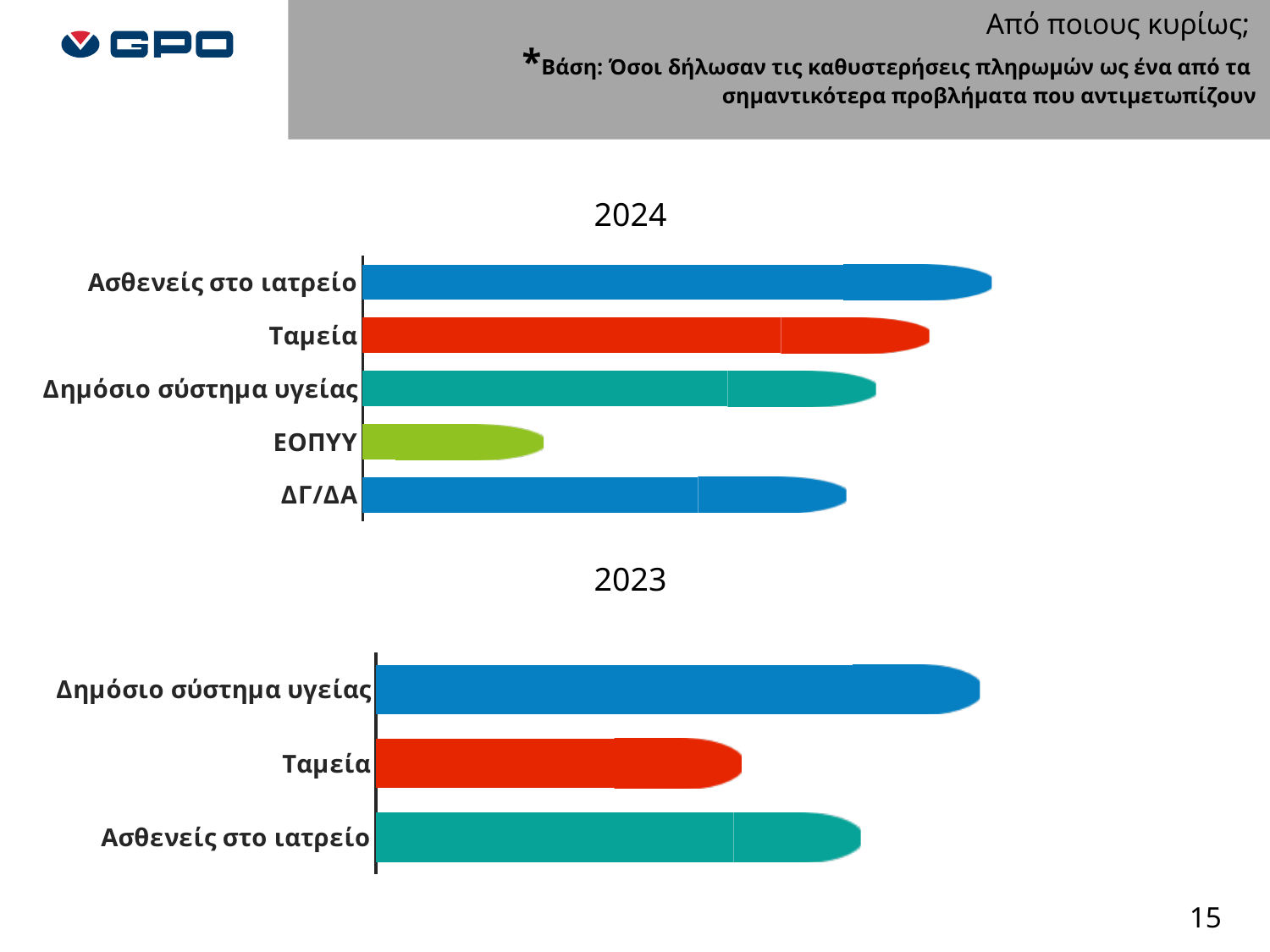
In the 2023 chart, which category has the longest bar? Δημόσιο σύστημα υγείας What is the title of the upper chart on the slide? 2024 In the 2024 chart, which category has the shortest bar? ΕΟΠΥΥ What is the title of the lower chart on the slide? 2023 What kind of chart is the 2024 chart? Bar chart How many categories are shown in the 2023 chart? 3 In the 2024 chart, which category has the longest bar? Ασθενείς στο ιατρείο In the 2023 chart, which is larger: Ασθενείς στο ιατρείο or Ταμεία? Ασθενείς στο ιατρείο In the 2023 chart, which category has the shortest bar? Ταμεία In the 2024 chart, which is larger: Ταμεία or Δημόσιο σύστημα υγείας? Ταμεία How many categories are shown in the 2024 chart? 5 In the 2024 chart, which is larger: Ασθενείς στο ιατρείο or ΕΟΠΥΥ? Ασθενείς στο ιατρείο